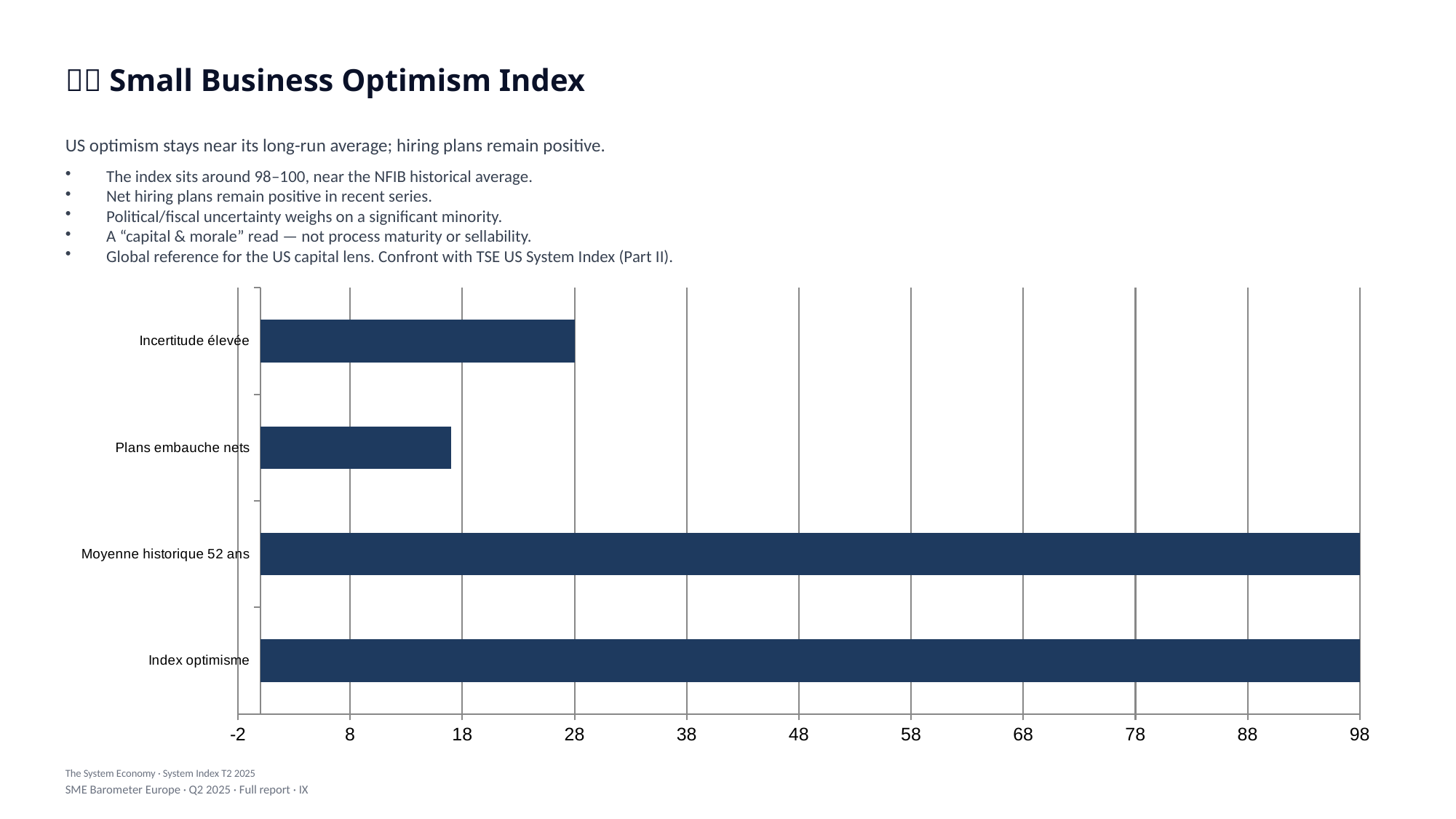
What is the title of the slide containing the chart? Small Business Optimism Index What is the value for Incertitude élevée? 28 What kind of chart is shown on the slide? bar chart What is the difference between the values for Index optimisme and Incertitude élevée? 70 Is the value for Plans embauche nets greater or less than 8? greater Is the value for Plans embauche nets greater or less than 18? less Which category has the lowest value? Plans embauche nets What is the value for Index optimisme? 98 How many categories are plotted in the chart? 4 Which is larger, Incertitude élevée or Plans embauche nets? Incertitude élevée Which is larger, Index optimisme or Incertitude élevée? Index optimisme What is the value for Moyenne historique 52 ans? 98